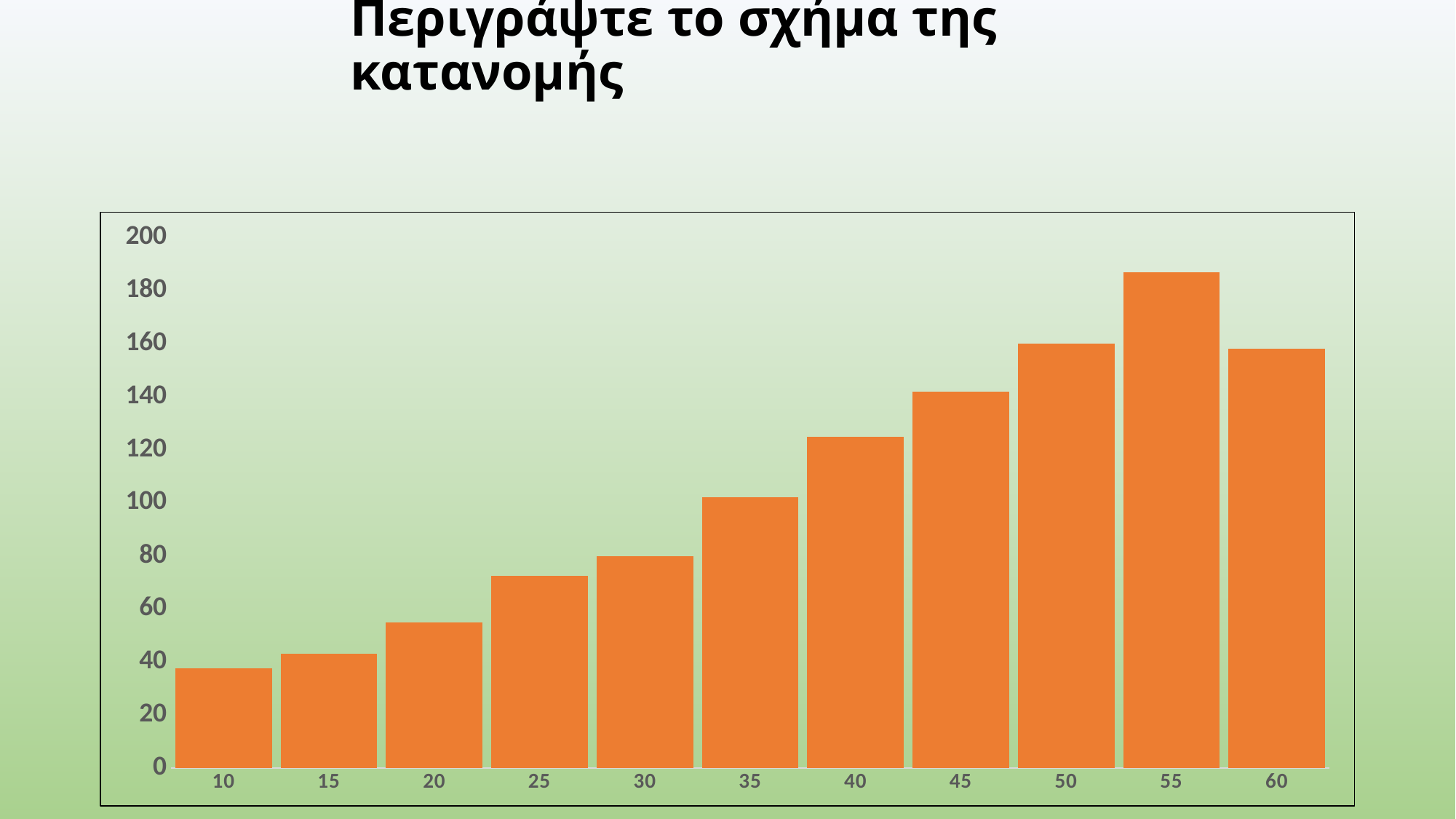
Is the value for 55 greater or less than 180? greater Which category has the lowest bar? 10 Is the value for 20 greater or less than 60? less What kind of chart is shown on the slide? bar chart How many bars are plotted in the chart? 11 Is the value for 60 greater or less than 140? greater Which is larger, the value for 55 or the value for 60? 55 Which category has the highest bar? 55 What is the title of the slide above the chart? Περιγράψτε το σχήμα της κατανομής Which is larger, the value for 30 or the value for 40? 40